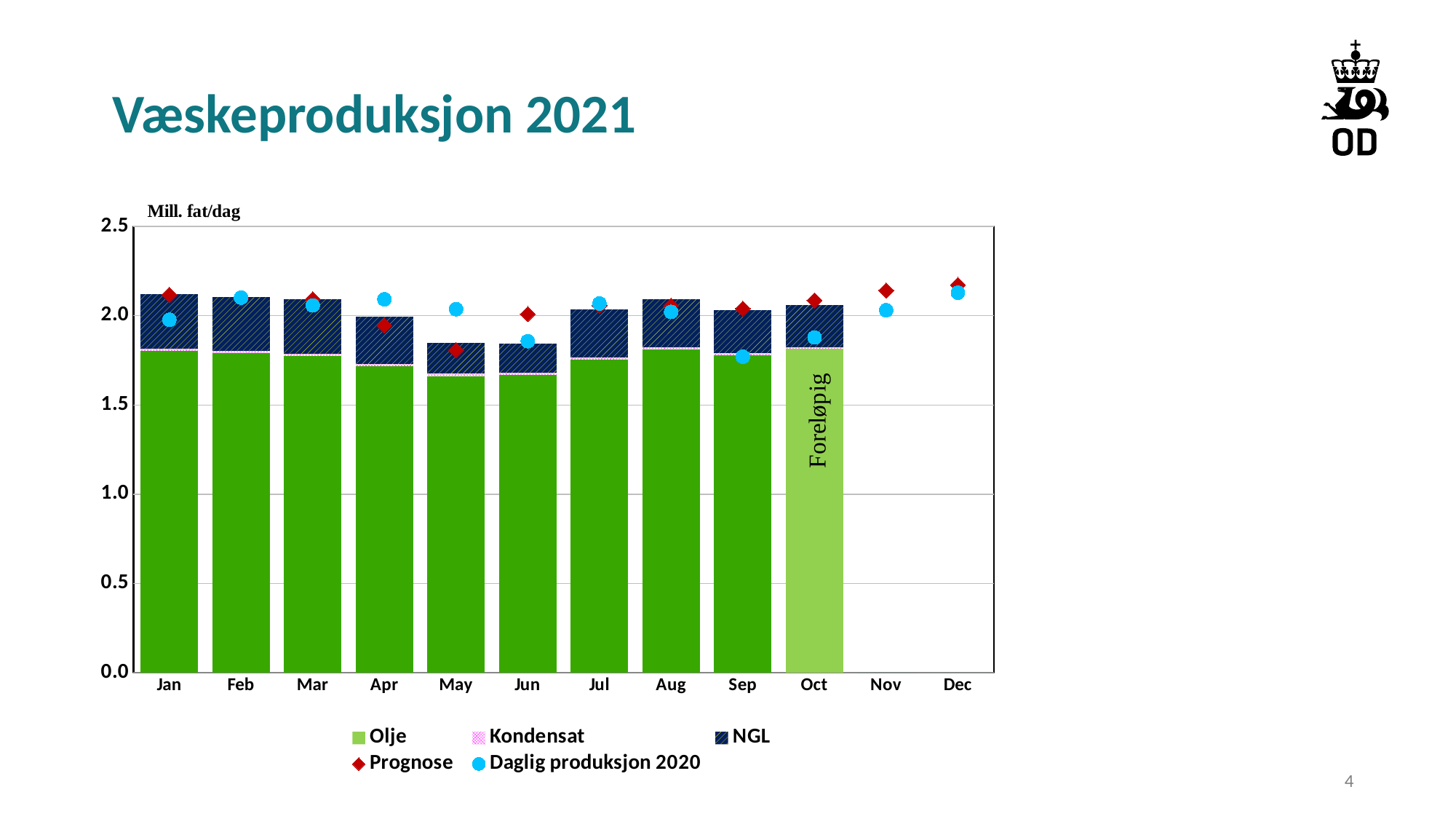
Is the Daglig produksjon 2020 value for Sep greater or less than 2.0? less Is the Prognose value for Dec greater or less than 2.0? greater What label is written on the Oct bar? Foreløpig Do the total stacked bars rise or fall from Jan to May? fall Is the total stacked bar for May greater or less than 2.0? less What kind of chart is shown on the slide? Stacked bar chart with point markers How many series does the legend list? 5 How many months have a stacked bar plotted? 10 Which has the larger total stacked bar, Jan or May? Jan How many months are shown on the x axis? 12